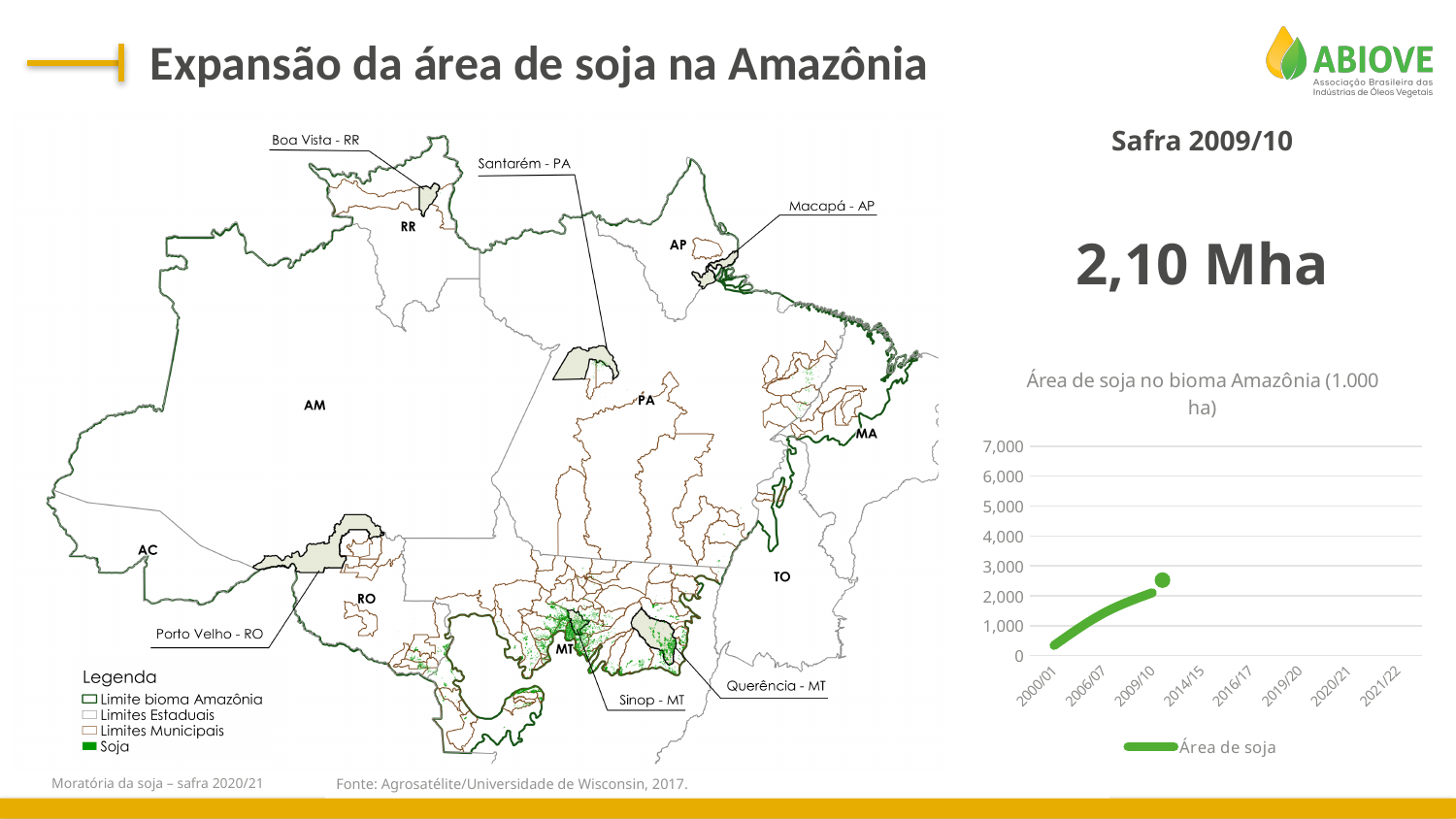
Is the value for 2006/07 in the chart greater or less than 1,000? greater What is the name of the series shown in the chart legend? Área de soja What kind of chart is shown on the right side of the slide? line chart How many categories are labelled on the x axis of the chart? 8 How many series does the legend of the chart list? 1 Is the value for 2000/01 in the chart greater or less than 1,000? less Which of the plotted points in the chart is highest, 2000/01 or 2009/10? 2009/10 What is the highest value shown on the y axis of the chart? 7,000 What is the title of the chart on the right side of the slide? Área de soja no bioma Amazônia (1.000 ha) Is the value for 2006/07 in the chart greater or less than 2,000? less Does the plotted line in the chart rise or fall from 2000/01 to 2009/10? rise